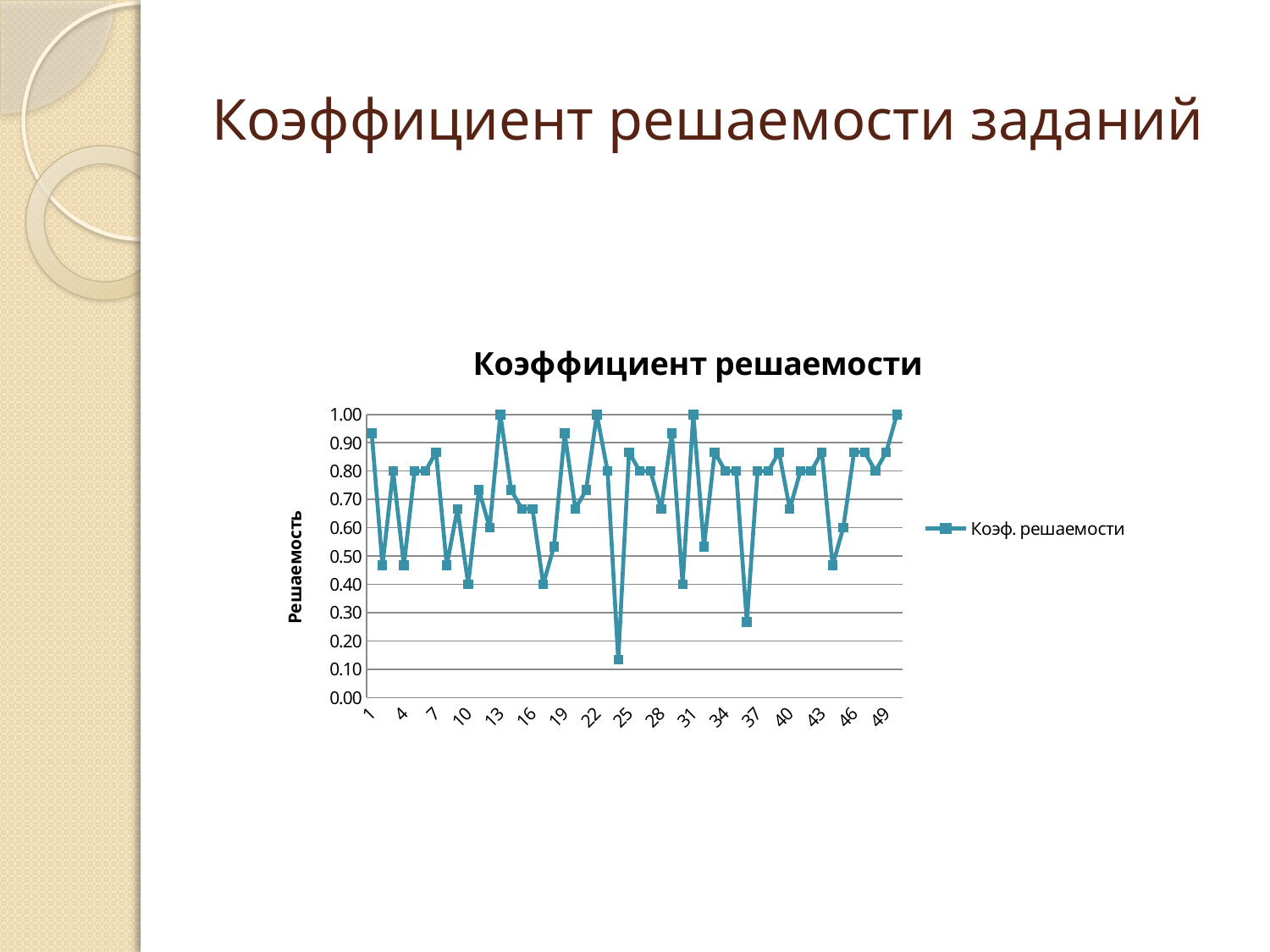
What is the title of the chart? Коэффициент решаемости What is the value for task 13? 1.00 Which is larger, the value for task 13 or the value for task 24? task 13 What kind of chart is shown on the slide? line chart Is the value for task 36 greater or less than 0.30? less What is the value for task 22? 1.00 How many series does the legend list? 1 Which task has the lowest coefficient? 24 Is the value for task 24 greater or less than 0.20? less Is the value for task 1 greater or less than 0.90? greater What is the highest value reached on the chart? 1.00 What is the label of the series in the legend? Коэф. решаемости